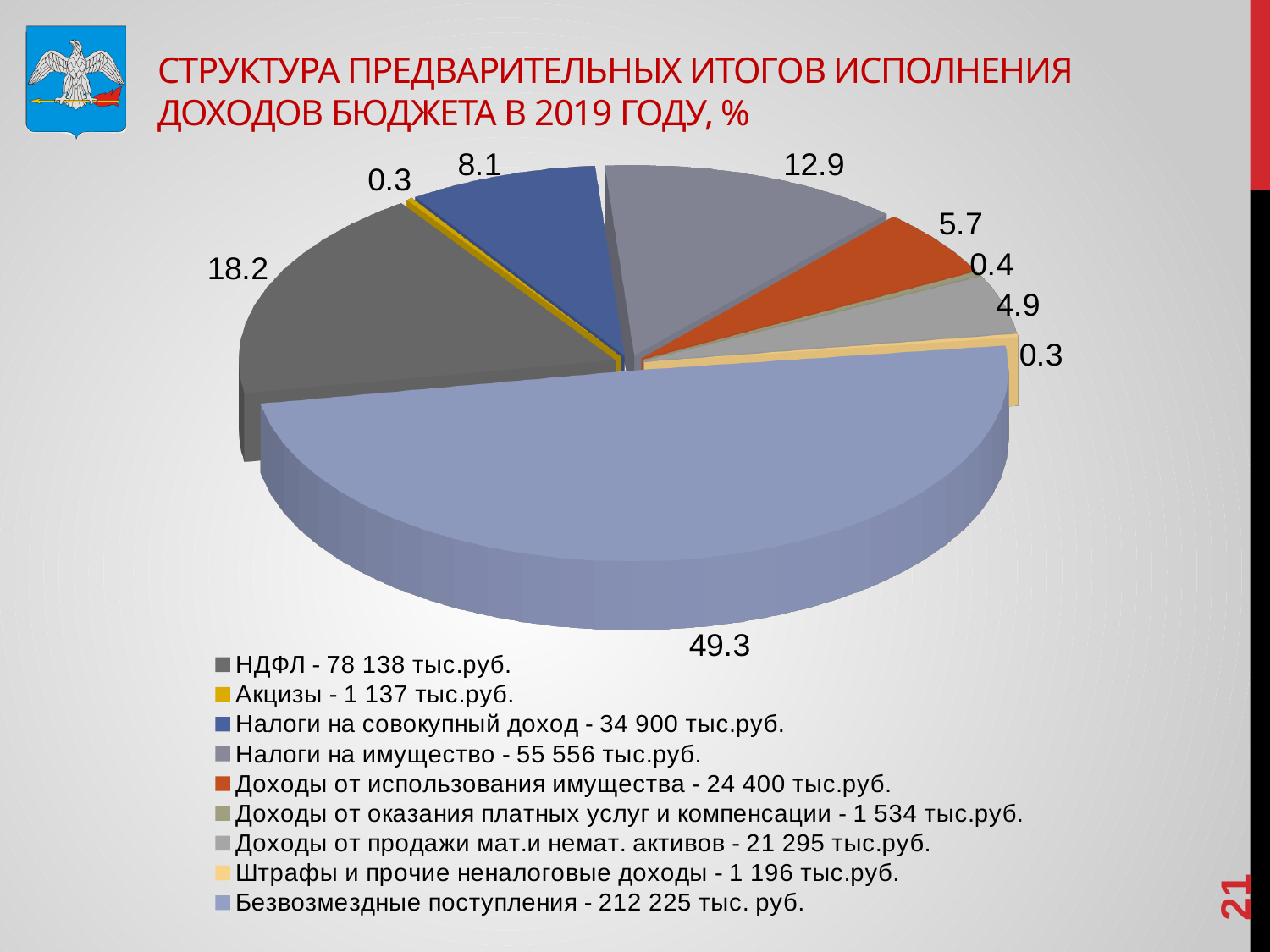
What amount in тыс.руб. does the legend give for Безвозмездные поступления? 212 225 тыс. руб. How many slices does the pie chart have? 9 What is the value shown for Налоги на совокупный доход? 8.1 What is the value shown for Доходы от продажи мат.и немат. активов? 4.9 What is the difference between the values for Безвозмездные поступления and НДФЛ? 31.1 What is the value shown for Доходы от использования имущества? 5.7 What is the value shown for НДФЛ? 18.2 Which is larger, the value for Налоги на имущество or the value for Налоги на совокупный доход? Налоги на имущество What share of the pie does Безвозмездные поступления have? 49.3 Which category has the largest slice of the pie? Безвозмездные поступления What type of chart is shown on the slide? pie chart What is the value shown for Налоги на имущество? 12.9